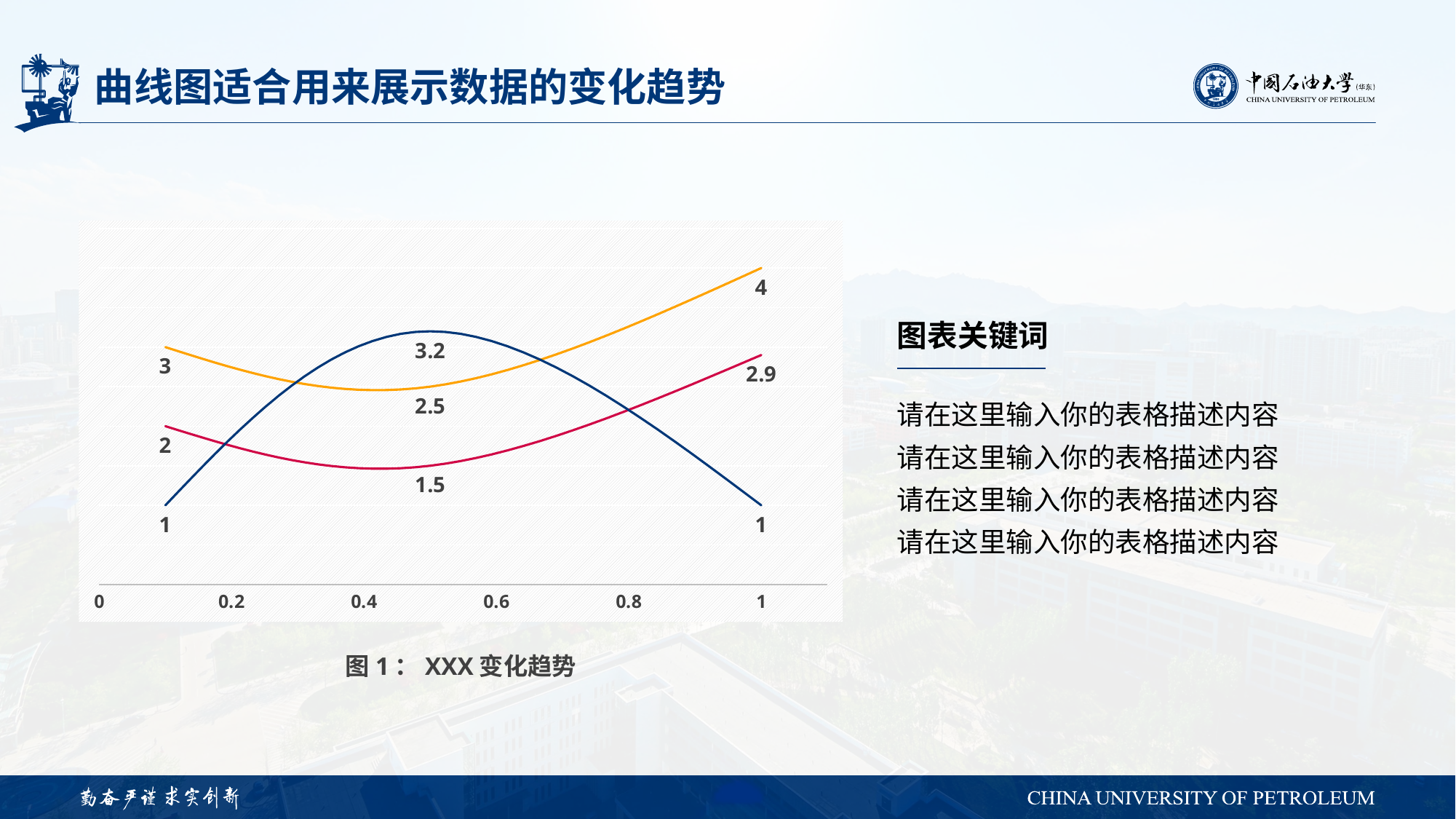
What is the value of the last (rightmost) labelled point on the red line? 2.9 How many lines are plotted in the chart? 3 What is the value of the middle labelled point on the blue line? 3.2 How many labelled data points does the orange line have? 3 What is the difference between the first and middle labelled values on the blue line (1 and 3.2)? 2.2 What is the caption printed below the chart? 图 1： XXX 变化趋势 Which is larger: the rightmost value of the orange line or the rightmost value of the red line? the orange line (4) What kind of chart is shown on the slide? line chart What is the value of the middle labelled point on the red line? 1.5 Does the red line rise or fall between its middle point and its last point? rise Which labelled point on the orange line has the highest value? the last (rightmost) point, 4 What is the value of the last (rightmost) labelled point on the orange line? 4